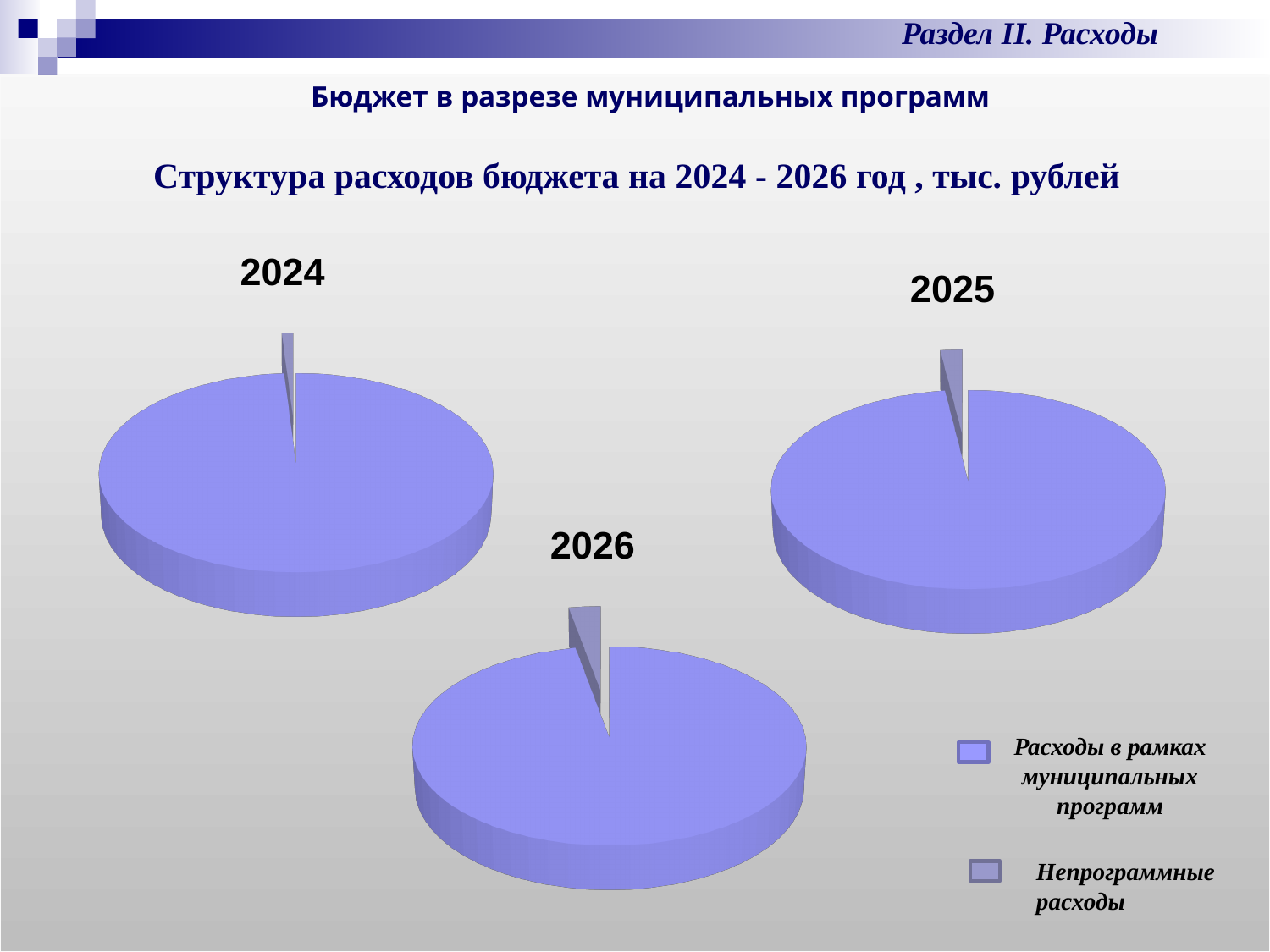
Which years are shown as pie chart titles on the slide? 2024, 2025, 2026 How many slices does the 2025 pie chart have? 2 In the 2025 pie chart, which category has the smaller slice? Непрограммные расходы In the 2024 pie chart, which category has the larger slice? Расходы в рамках муниципальных программ What is the title above the three pie charts? Структура расходов бюджета на 2024 - 2026 год , тыс. рублей In the 2026 pie chart, which category takes up most of the pie? Расходы в рамках муниципальных программ How many pie charts are shown on the slide? 3 How many categories does the legend list? 2 In the 2026 pie chart, is the slice for Непрограммные расходы larger or smaller than the slice for Расходы в рамках муниципальных программ? smaller What kind of chart is used for the 2024 chart? pie chart